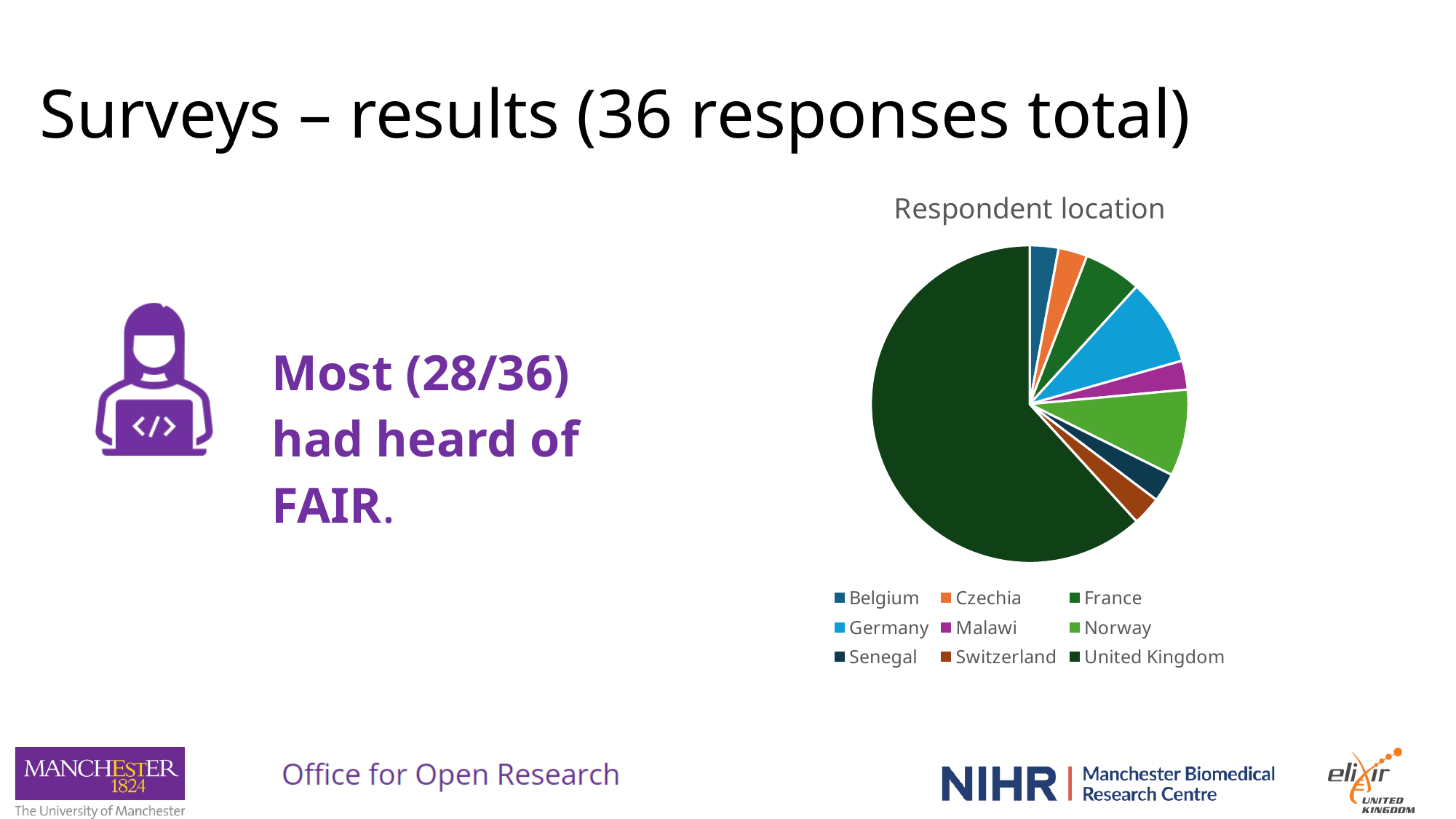
Which slice is larger, United Kingdom or Germany? United Kingdom Which category is shown in orange in the legend? Czechia How many categories does the pie chart show? 9 What is the title of the chart? Respondent location Which category has the largest slice of the pie? United Kingdom What kind of chart is shown on the slide? pie chart Does the United Kingdom slice take up more or less than half of the pie? more Which slice is larger, Germany or Senegal? Germany